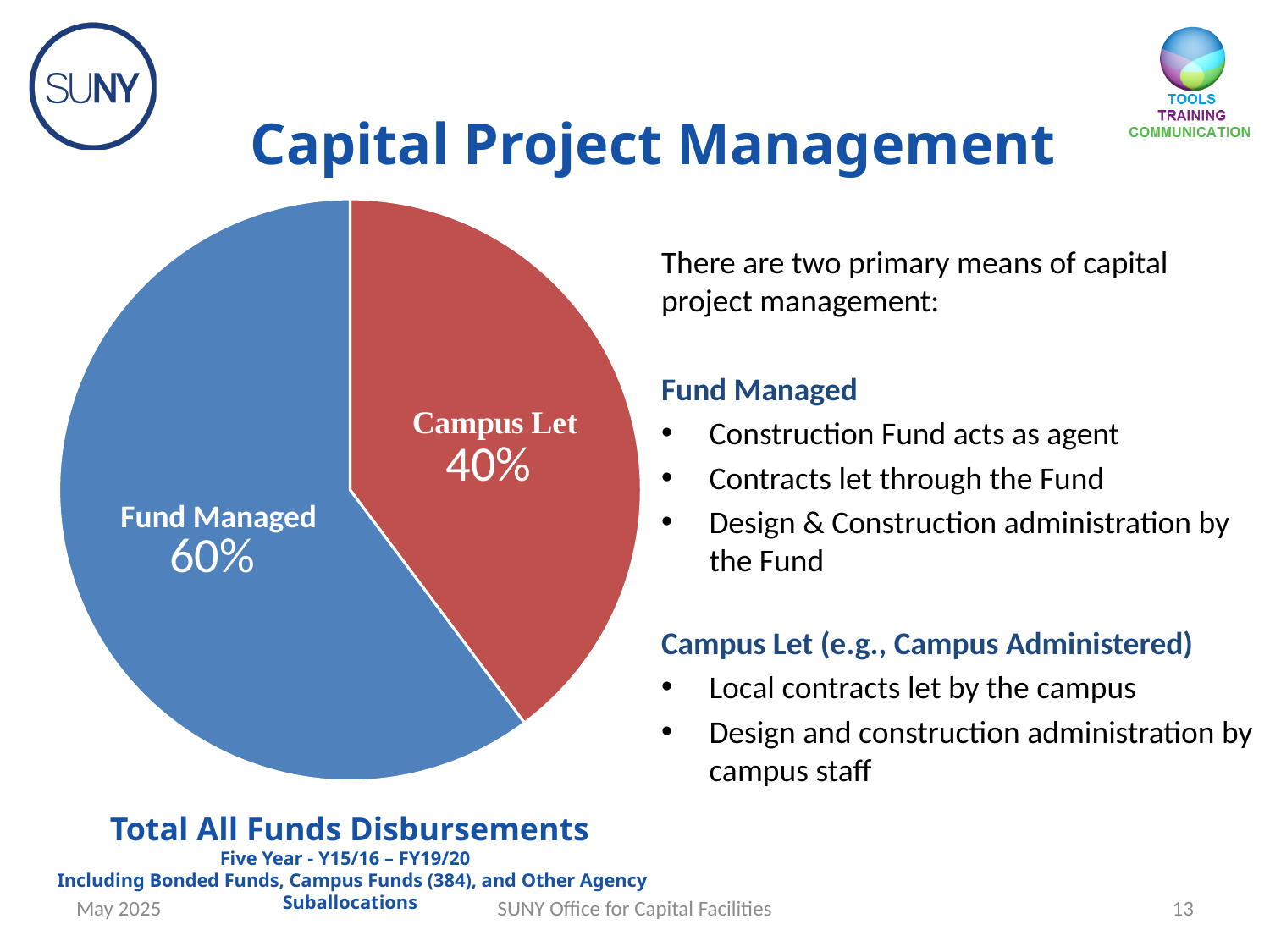
What do the two slices of the pie add up to? 100% What is the difference in percentage points between the Fund Managed and Campus Let slices? 20 percentage points What share of the pie does Campus Let represent? 40% Which slice of the pie is the smallest? Campus Let What is the title of the chart? Total All Funds Disbursements What colour is the Fund Managed slice? Blue Which is larger, the Fund Managed slice or the Campus Let slice? Fund Managed What kind of chart is shown on the slide? Pie chart What share of the pie does Fund Managed represent? 60% Which slice of the pie is the largest? Fund Managed How many slices does the pie chart have? 2